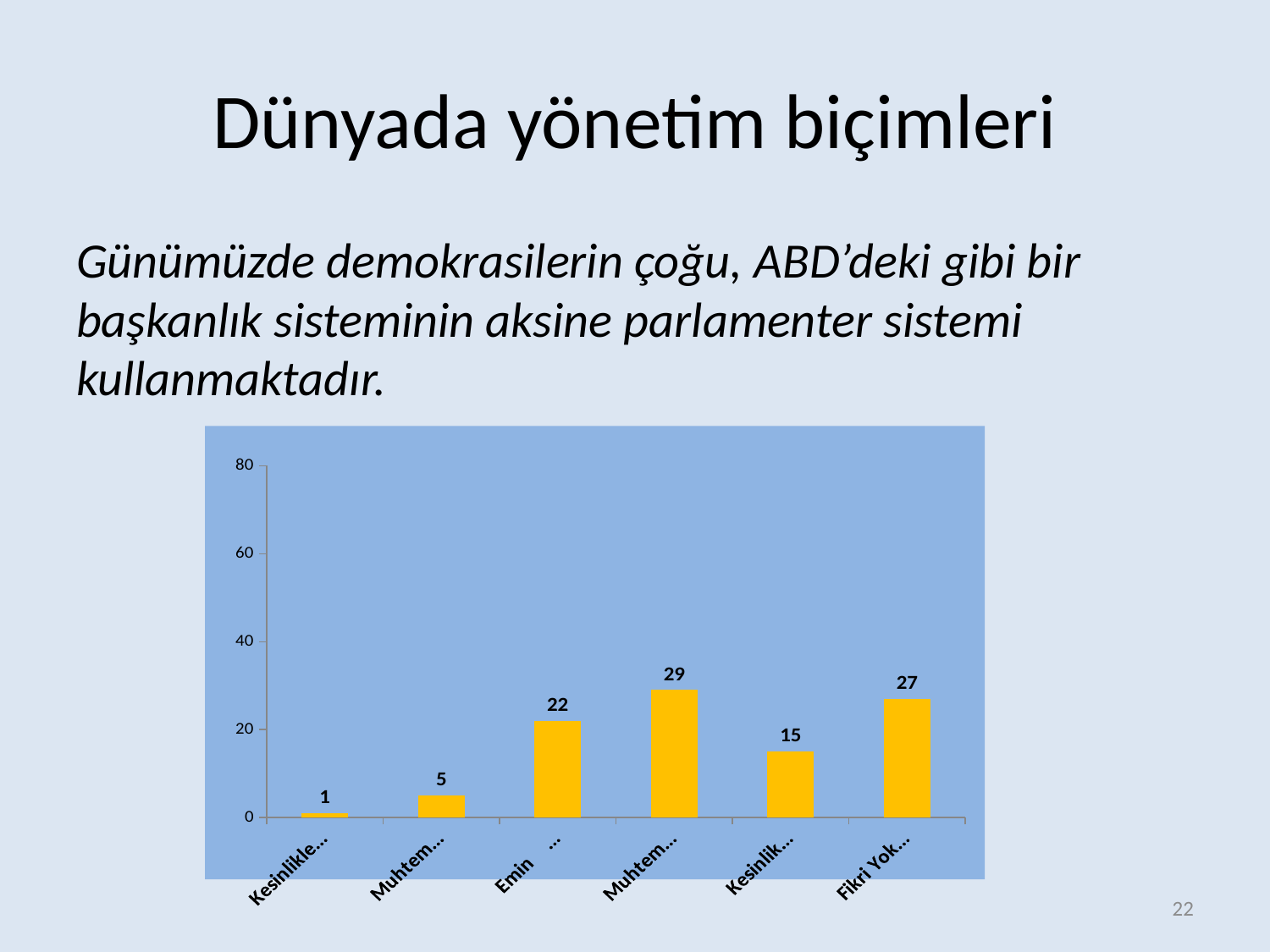
What type of chart is shown on the slide? bar chart Which bar has the highest value in the chart? the fourth bar (29) Which bar has the lowest value in the chart? the first bar (1) What is the value of the bar labelled "Emin ..."? 22 What is the highest value shown on the vertical axis of the chart? 80 What is the value of the bar labelled "Fikri Yok..."? 27 Which is larger: the value of the bar labelled "Emin ..." or the value of the fifth bar from the left? Emin ... (22) How many bars does the chart show? 6 What is the value of the first (leftmost) bar in the chart? 1 What is the value of the fifth bar from the left in the chart? 15 Is the value of the fourth bar greater or less than 40? less What is the difference between the highest bar (29) and the bar labelled "Fikri Yok..." (27)? 2